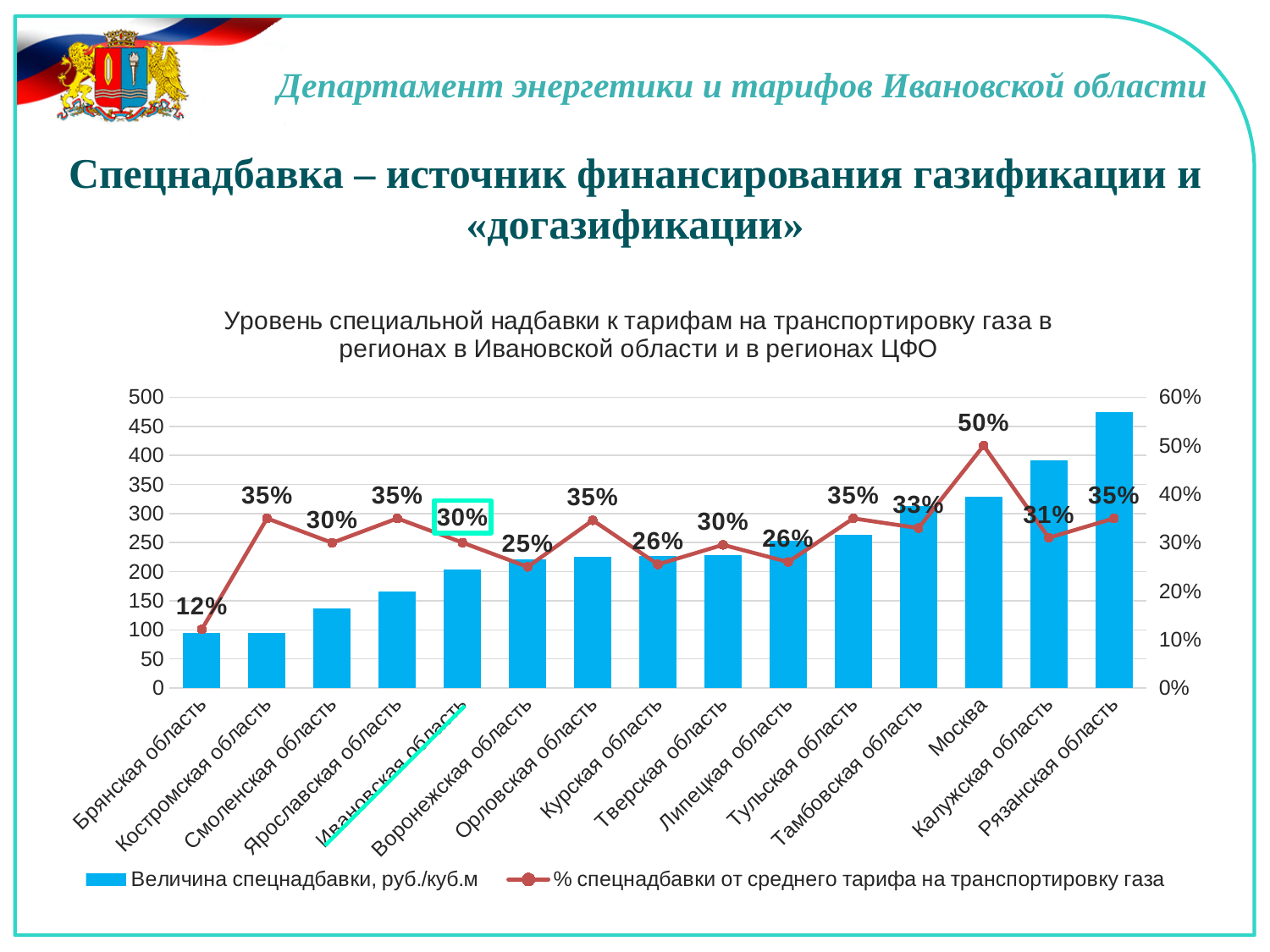
What is the value of the line series (% спецнадбавки от среднего тарифа) for Ивановская область? 30% What is the difference between the line-series values for Москва and Калужская область? 19% Which region has the lowest value on the line series (% спецнадбавки от среднего тарифа)? Брянская область What is the value of the line series for Москва? 50% How many regions are shown on the x axis of the chart? 15 What is the value of the line series for Брянская область? 12% Is the bar value (Величина спецнадбавки, руб./куб.м) for Рязанская область greater or less than 400? greater Which region has the highest value on the line series (% спецнадбавки от среднего тарифа)? Москва Which has a larger line-series value: Тамбовская область or Воронежская область? Тамбовская область How many series does the chart legend list? 2 Is the bar value (Величина спецнадбавки, руб./куб.м) for Брянская область greater or less than 150? less Do the bar values (Величина спецнадбавки, руб./куб.м) generally rise or fall from left to right along the x axis? rise